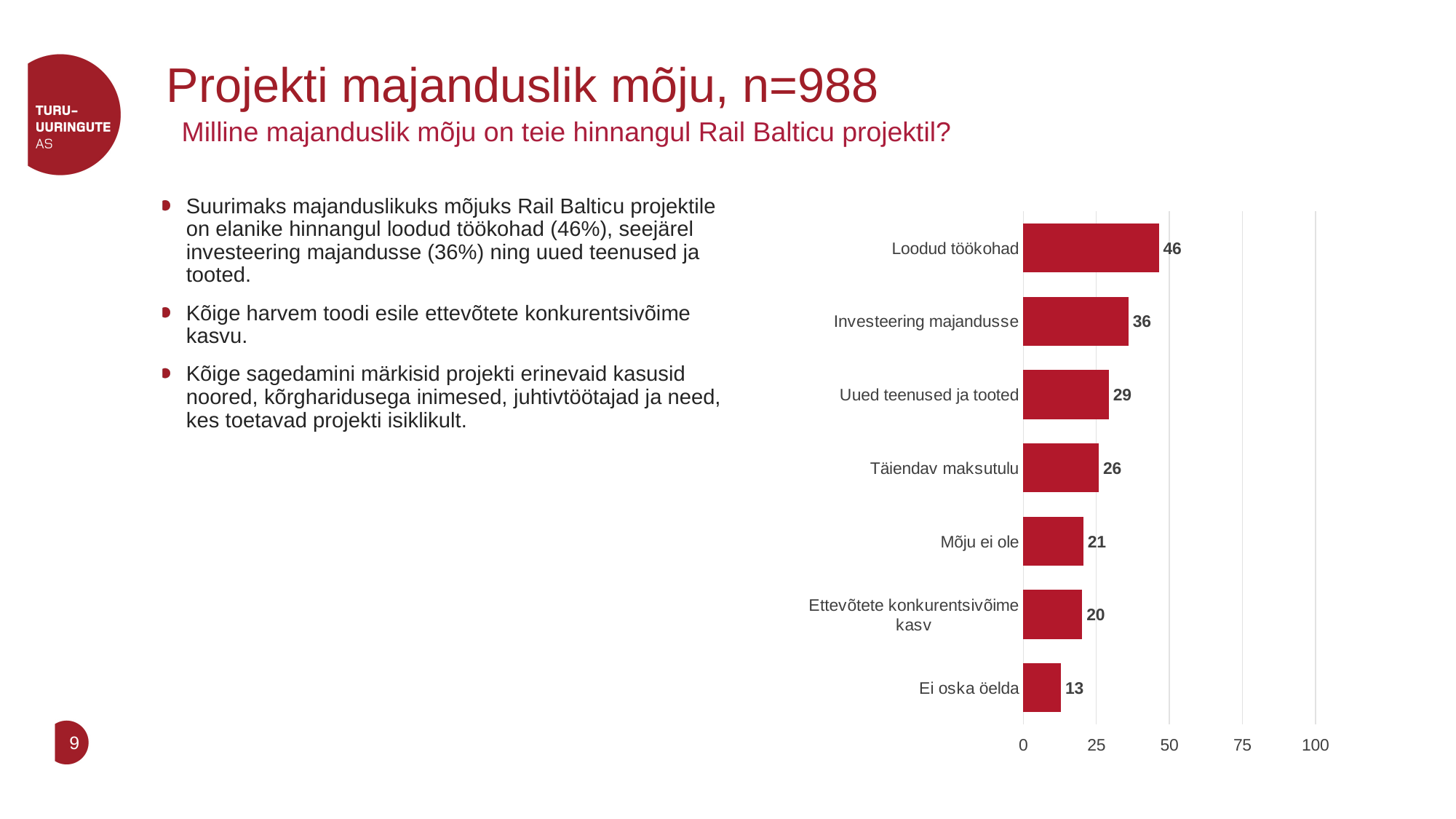
How many categories are shown in the chart? 7 Is the value for "Investeering majandusse" greater or less than 25? greater Which category has the highest value? Loodud töökohad What is the difference between the values for "Loodud töökohad" and "Investeering majandusse"? 10 What is the difference between the values for "Uued teenused ja tooted" and "Ei oska öelda"? 16 What kind of chart is shown on the slide? Bar chart What is the value for "Ettevõtete konkurentsivõime kasv"? 20 What is the highest tick value shown on the value axis of the chart? 100 Which is larger, the value for "Mõju ei ole" or the value for "Täiendav maksutulu"? Täiendav maksutulu What is the value for "Loodud töökohad"? 46 What is the value for "Täiendav maksutulu"? 26 Which category has the lowest value? Ei oska öelda